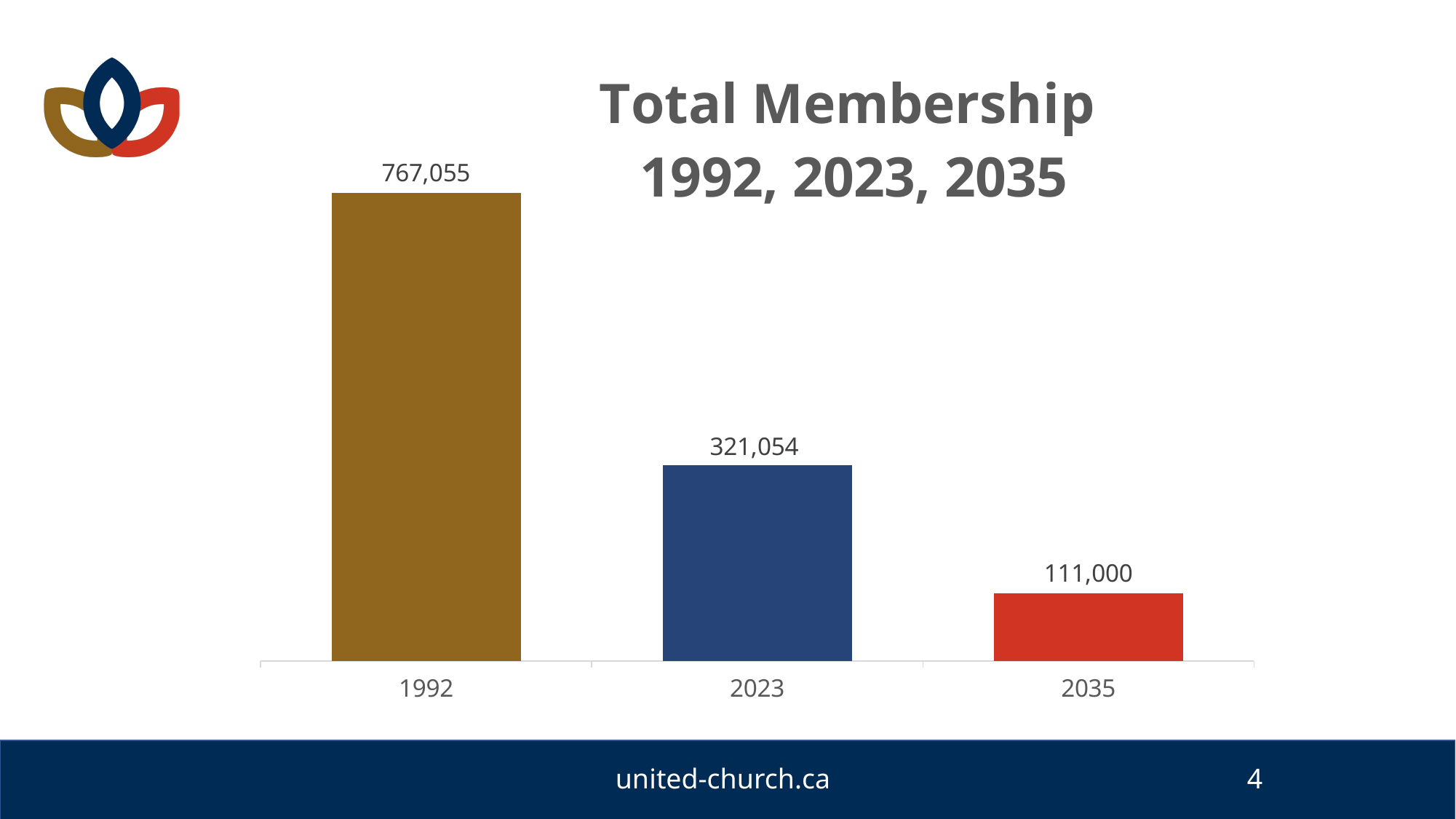
How many years are shown on the chart? 3 Which year has a larger total membership, 2023 or 2035? 2023 What kind of chart is shown on the slide? Bar chart What is the total membership shown for 1992? 767,055 What is the total membership shown for 2023? 321,054 What is the total membership shown for 2035? 111,000 What is the difference in total membership between 2023 and 2035? 210,054 Which year has the highest total membership? 1992 Do the membership values rise or fall from 1992 to 2035? Fall What is the difference in total membership between 1992 and 2023? 446,001 Which year has the lowest total membership? 2035 What is the title of the chart? Total Membership 1992, 2023, 2035